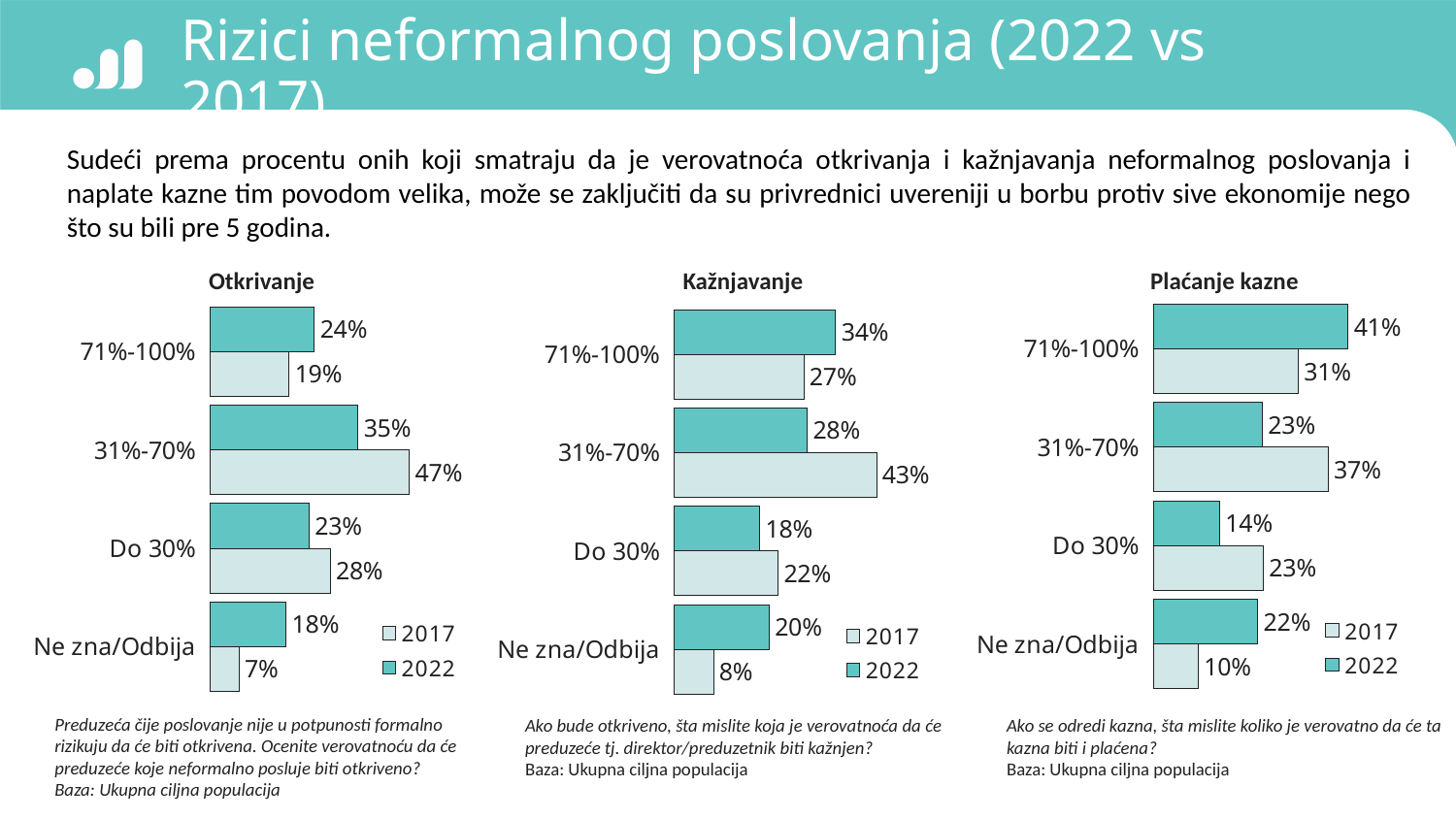
In the 'Plaćanje kazne' chart, what is the 2022 value for the 'Do 30%' category? 14% In the 'Plaćanje kazne' chart, what is the difference between the 2022 and 2017 values for the 71%-100% category? 10% In the 'Kažnjavanje' chart, which is larger for the 71%-100% category: the 2017 value or the 2022 value? 2022 In the 'Kažnjavanje' chart, what is the 2017 value for 'Ne zna/Odbija'? 8% In the 'Otkrivanje' chart, what is the 2022 value for the 71%-100% category? 24% In the 'Plaćanje kazne' chart, which category has the highest 2022 value? 71%-100% In the 'Kažnjavanje' chart, which category has the lowest 2017 value? Ne zna/Odbija In the 'Otkrivanje' chart, what is the difference between the 2017 and 2022 values for the 31%-70% category? 12% How many categories are shown in the 'Otkrivanje' chart? 4 What type of chart is the 'Plaćanje kazne' chart? Bar chart In the 'Otkrivanje' chart, what is the 2017 value for the 31%-70% category? 47% How many series does the legend of the 'Kažnjavanje' chart list? 2